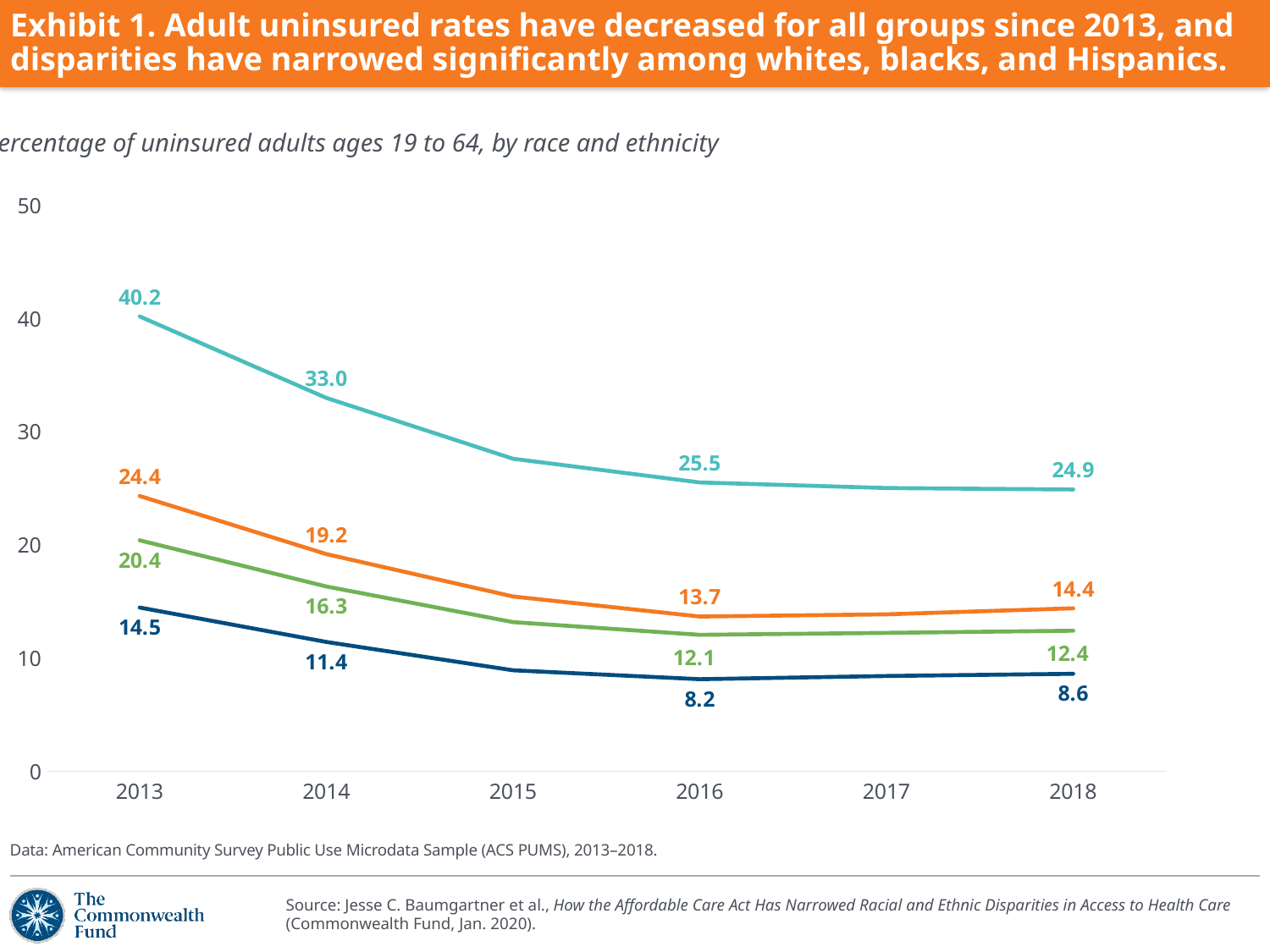
What kind of chart is this? Line chart What is the value of the orange line in 2018? 14.4 How many years are shown on the x axis? 6 Is the value of the light teal line in 2015 greater or less than 30? less What is the value of the light teal line in 2013? 40.2 What is the value of the green line in 2014? 16.3 Which line has the lowest value in 2018? The dark blue line (8.6) What is the difference between the orange line and the green line in 2016? 1.6 Which is larger in 2014: the orange line or the green line? The orange line (19.2) Which line has the highest value in 2013? The light teal line (40.2) By how much did the light teal line fall from 2013 to 2018? 15.3 What is the value of the dark blue line in 2016? 8.2